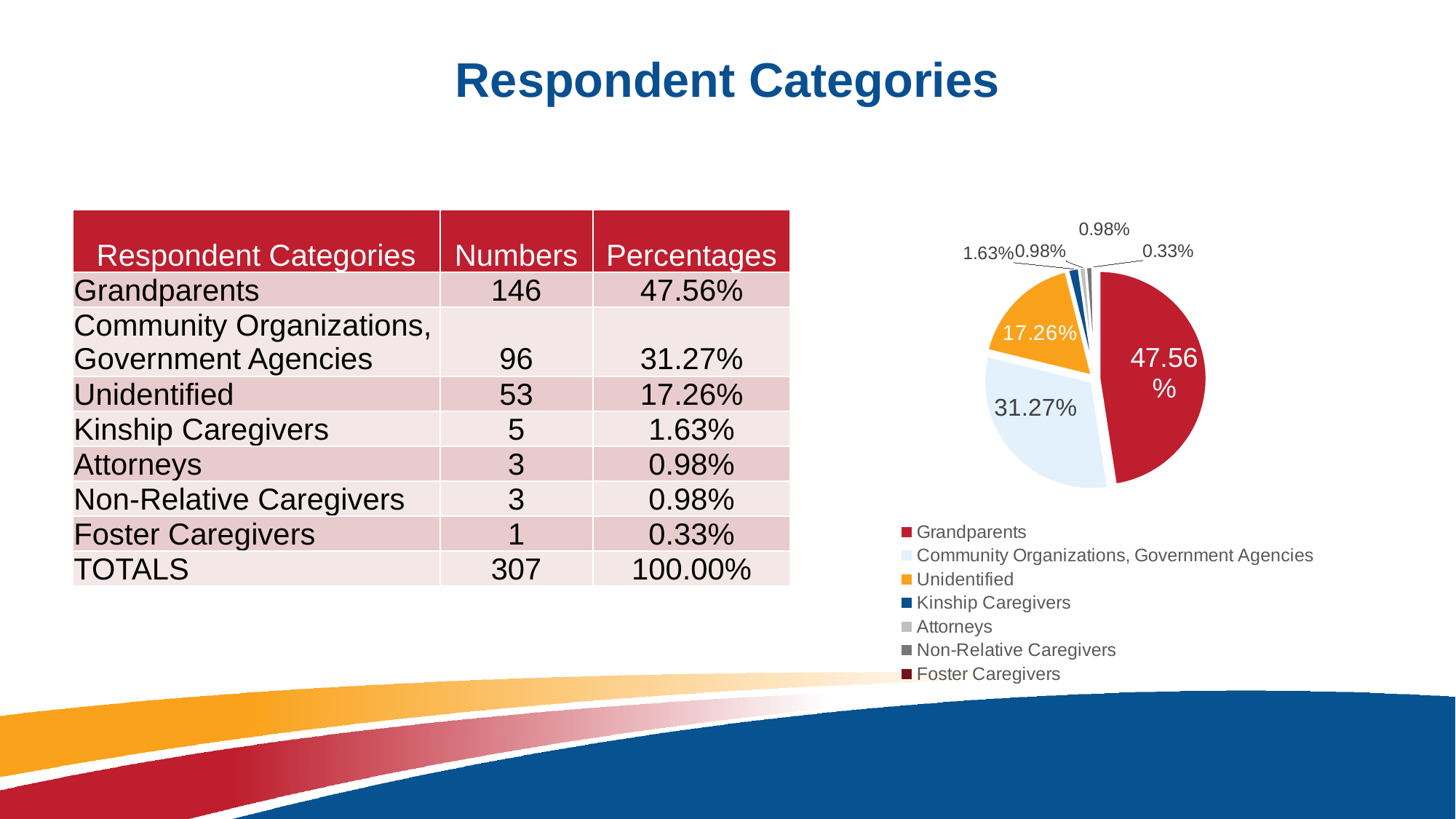
What share of the pie does Unidentified represent? 17.26% What colour is the Unidentified slice in the pie chart? orange Which category has the largest slice of the pie? Grandparents What share of the pie does Kinship Caregivers represent? 1.63% What share of the pie does Foster Caregivers represent? 0.33% Which slice is larger, Unidentified or Community Organizations, Government Agencies? Community Organizations, Government Agencies How many categories does the pie chart legend list? 7 What kind of chart is shown on the slide? pie chart What is the difference in percentage points between the Grandparents slice and the Community Organizations, Government Agencies slice? 16.29% Which category has the smallest slice of the pie? Foster Caregivers